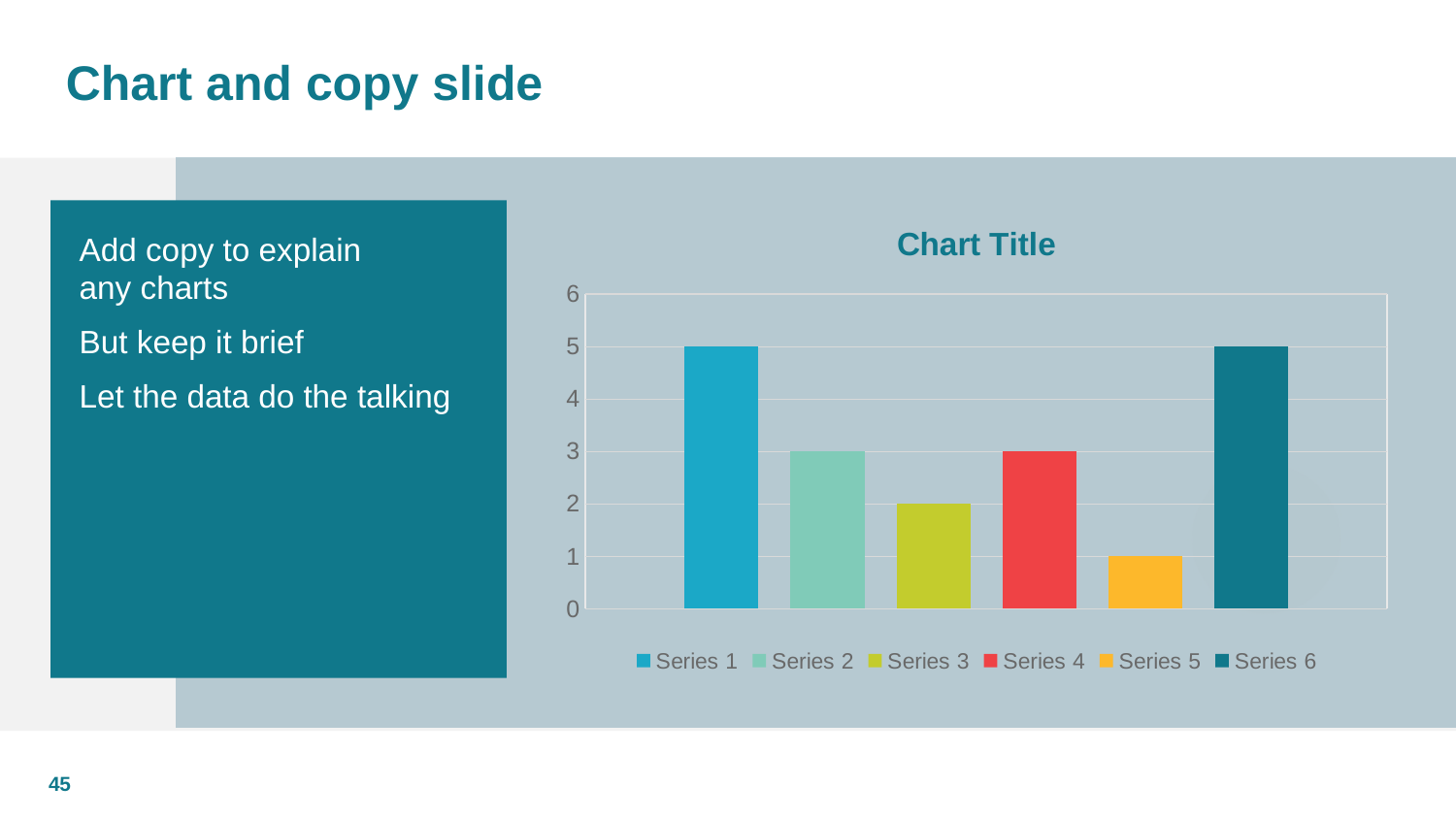
What is the value for Series 5? 1 What is the difference between the values for Series 1 and Series 3? 3 What is the value for Series 3? 2 What kind of chart is shown on the slide? bar chart Which series has the lowest value? Series 5 Is the value for Series 6 greater or less than 4? greater How many series does the legend list? 6 What is the value for Series 2? 3 What is the value for Series 6? 5 What is the title of the chart? Chart Title Which is larger, the value for Series 4 or the value for Series 5? Series 4 What is the value for Series 1? 5